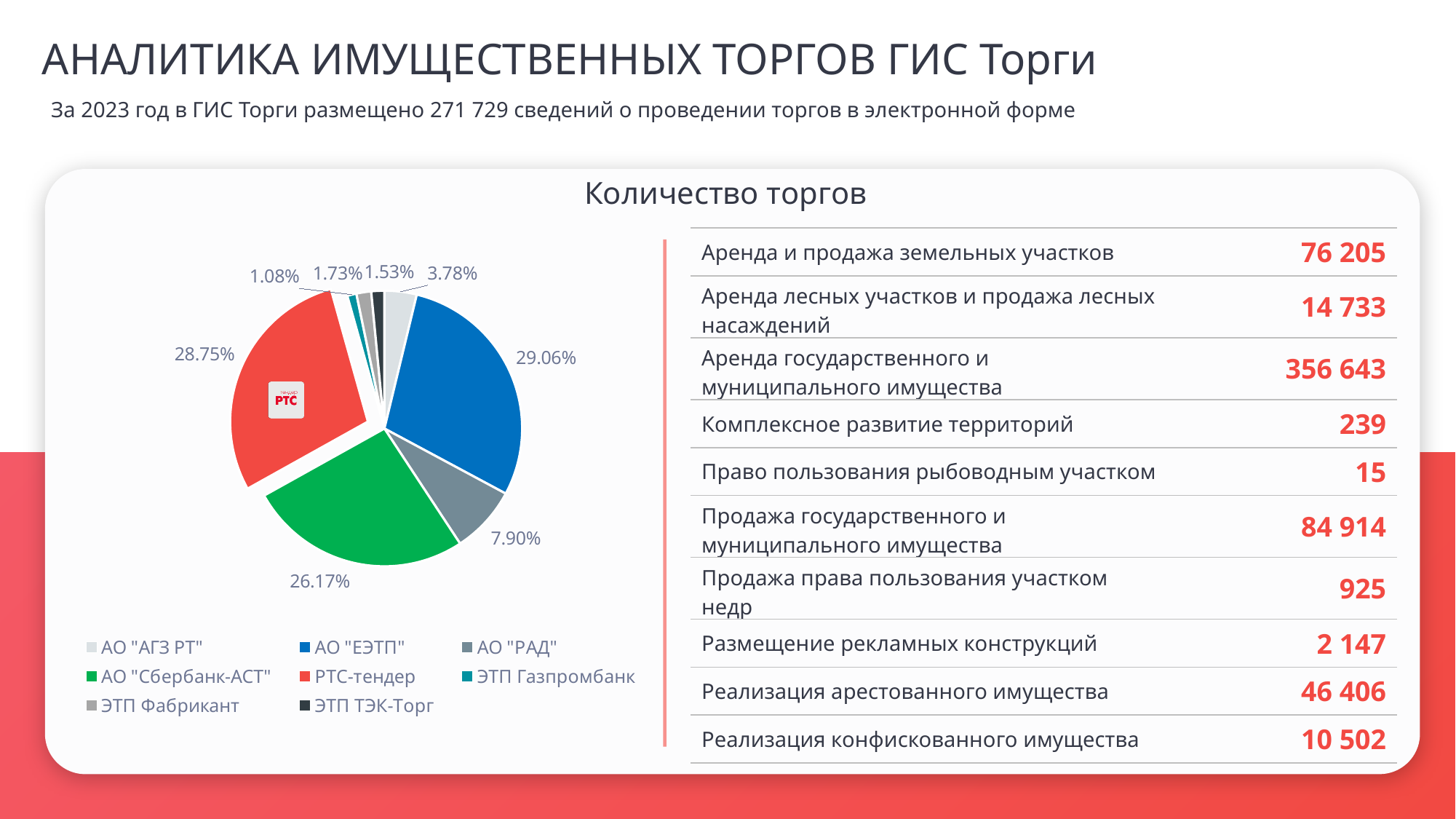
Which platform has the smallest slice of the pie chart? ЭТП Газпромбанк What share of the pie chart does АО "Сбербанк-АСТ" have? 26.17% What is the title of the chart? Количество торгов What share of the pie chart does АО "РАД" have? 7.90% How many platforms are listed in the pie chart's legend? 8 Which has a larger share of the pie chart, АО "Сбербанк-АСТ" or АО "РАД"? АО "Сбербанк-АСТ" Which platform has the largest slice of the pie chart? АО "ЕЭТП" By how many percentage points does the share of АО "ЕЭТП" exceed that of РТС-тендер? 0.31% What share of the pie chart does АО "ЕЭТП" have? 29.06% What share of the pie chart does РТС-тендер have? 28.75% What share of the pie chart does АО "АГЗ РТ" have? 3.78% What kind of chart is shown on the slide? pie chart